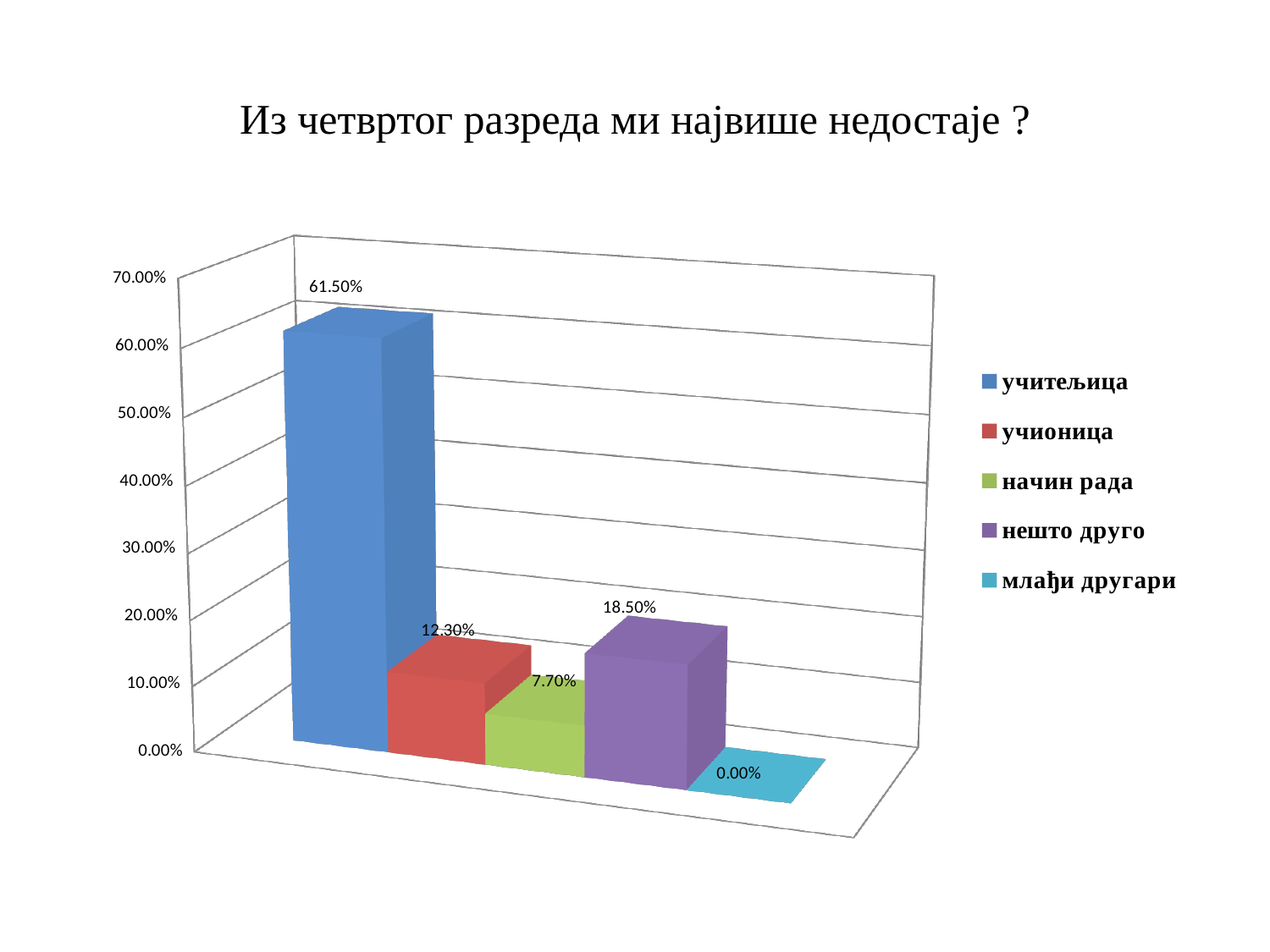
What is the difference between the values for учитељица and нешто друго? 43.00% What is the title of the slide? Из четвртог разреда ми највише недостаје ? What is the value for млађи другари? 0.00% What kind of chart is shown on the slide? bar chart What is the value for нешто друго? 18.50% Which category has the highest value? учитељица Which category has the lowest value? млађи другари What is the value for учионица? 12.30% Which is larger, the value for учионица or the value for нешто друго? нешто друго What is the value for учитељица? 61.50% How many categories does the legend list? 5 What is the value for начин рада? 7.70%